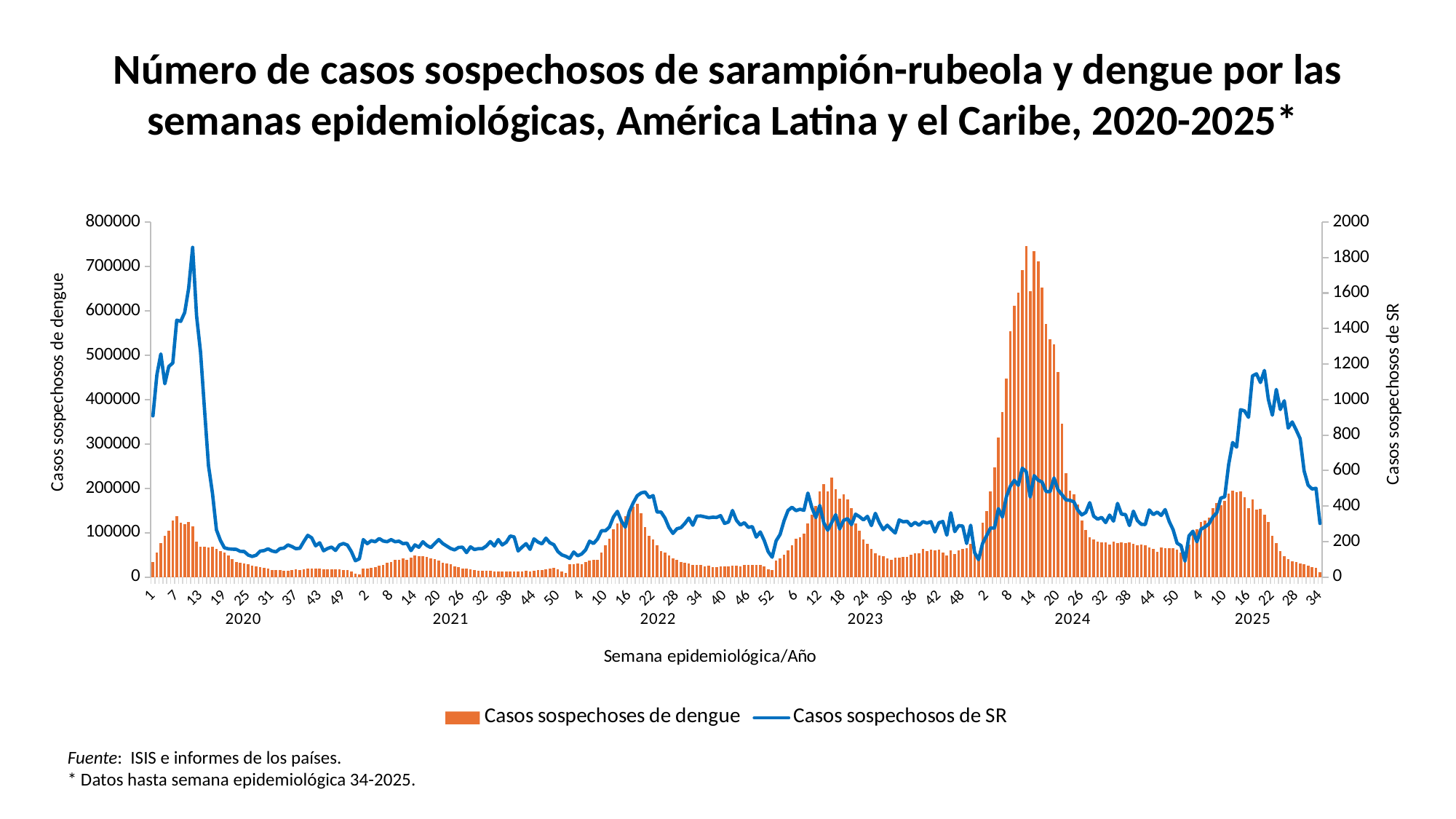
Which series is drawn as bars? Casos sospechoses de dengue Is the peak of the SR line in 2025 greater or less than 1000? greater Is the peak of the SR line in 2020 greater or less than 1800? greater What is the title of the right-hand vertical axis? Casos sospechosos de SR Which year has the higher SR peak, 2020 or 2025? 2020 What kind of chart is this? A combined bar and line chart Is the highest dengue bar in 2022 greater or less than 200000? less In which year does the SR line reach its highest peak? 2020 In which year do the dengue bars reach their highest peak? 2024 Does the SR line rise or fall between week 13 and week 19 of 2020? fall How many series does the legend list? 2